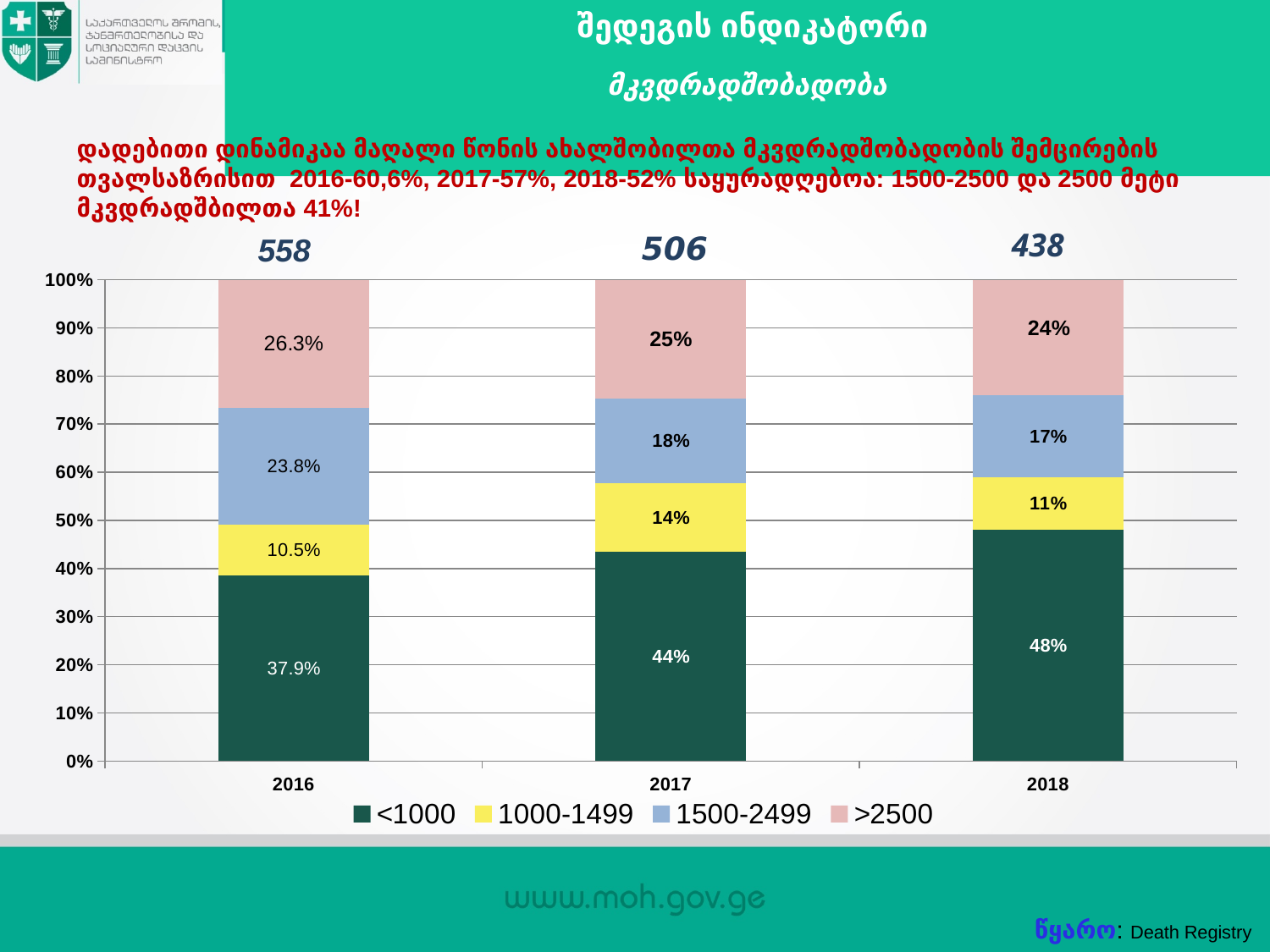
How many years are shown on the x axis? 3 What is the difference between the <1000 share in 2018 and in 2017? 4% What is the value for the 1500-2499 series in 2016? 23.8% What is the value for the >2500 series in 2018? 24% What is the value for the 1000-1499 series in 2017? 14% What number is printed above the 2017 bar? 506 In which year is the <1000 series share the highest? 2018 How many series does the legend list? 4 What is the value for the <1000 series in 2016? 37.9% In which year is the 1000-1499 series share the lowest? 2016 Which is larger: the >2500 share in 2016 or the >2500 share in 2017? 2016 What kind of chart is shown on the slide? Stacked bar chart